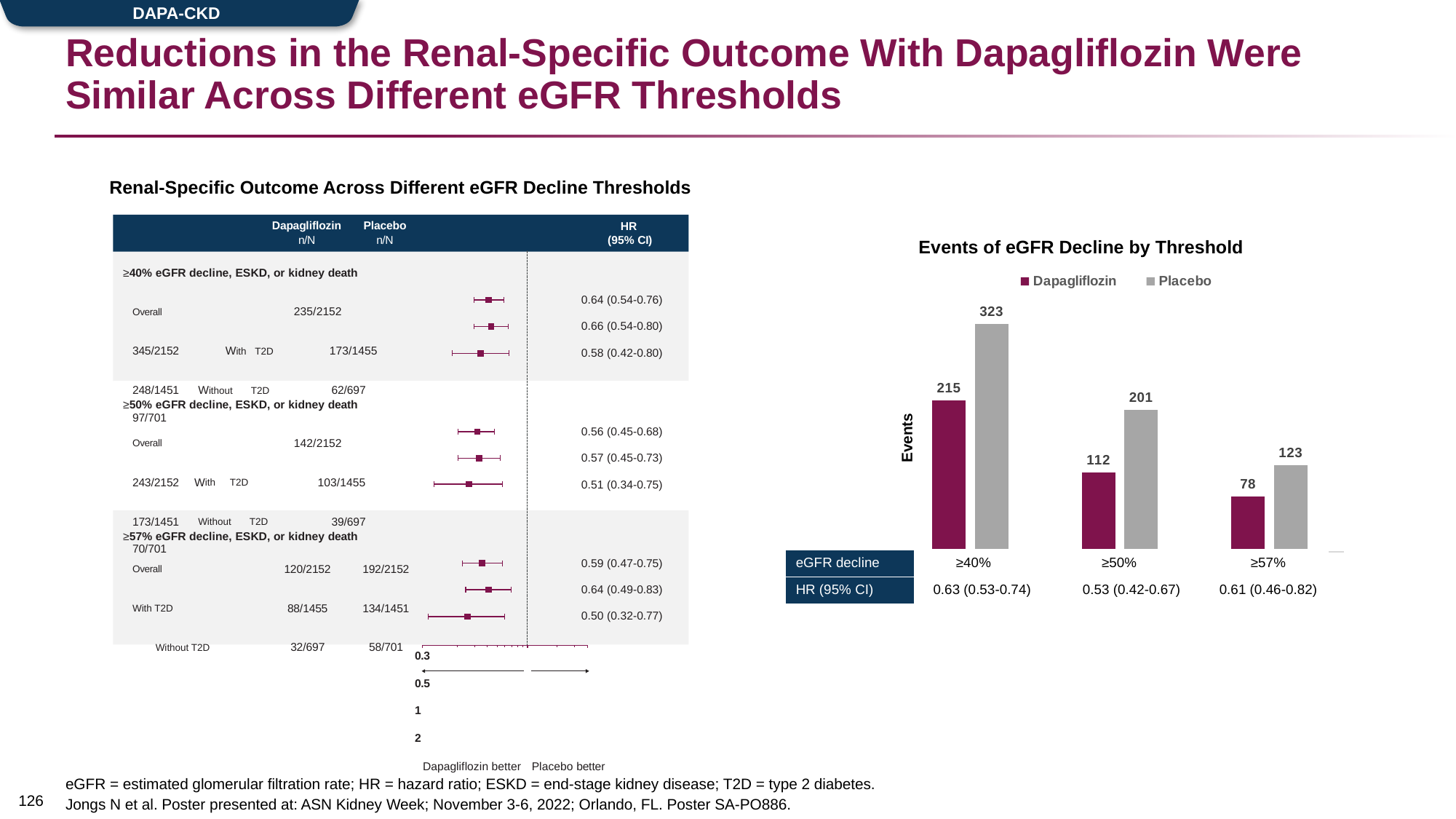
In the 'Events of eGFR Decline by Threshold' chart, what is the HR (95% CI) shown beneath the ≥50% eGFR decline threshold? 0.53 (0.42-0.67) In the 'Events of eGFR Decline by Threshold' chart, how many events are shown for Dapagliflozin at the ≥40% eGFR decline threshold? 215 In the 'Events of eGFR Decline by Threshold' chart, what is the difference between Placebo and Dapagliflozin events at the ≥40% threshold? 108 In the 'Events of eGFR Decline by Threshold' chart, how many series does the legend list? 2 In the 'Events of eGFR Decline by Threshold' chart, how many events are shown for Dapagliflozin at the ≥57% eGFR decline threshold? 78 In the 'Events of eGFR Decline by Threshold' chart, which has more events at the ≥50% threshold, Dapagliflozin or Placebo? Placebo In the 'Events of eGFR Decline by Threshold' chart, what is the difference between Placebo and Dapagliflozin events at the ≥57% threshold? 45 In the 'Events of eGFR Decline by Threshold' chart, how many eGFR decline thresholds are shown on the x axis? 3 In the 'Events of eGFR Decline by Threshold' chart, how many events are shown for Placebo at the ≥50% eGFR decline threshold? 201 In the 'Events of eGFR Decline by Threshold' chart, which eGFR decline threshold has the lowest number of Dapagliflozin events? ≥57% In the 'Events of eGFR Decline by Threshold' chart, which eGFR decline threshold has the highest number of Placebo events? ≥40% What kind of chart is 'Events of eGFR Decline by Threshold'? Bar chart